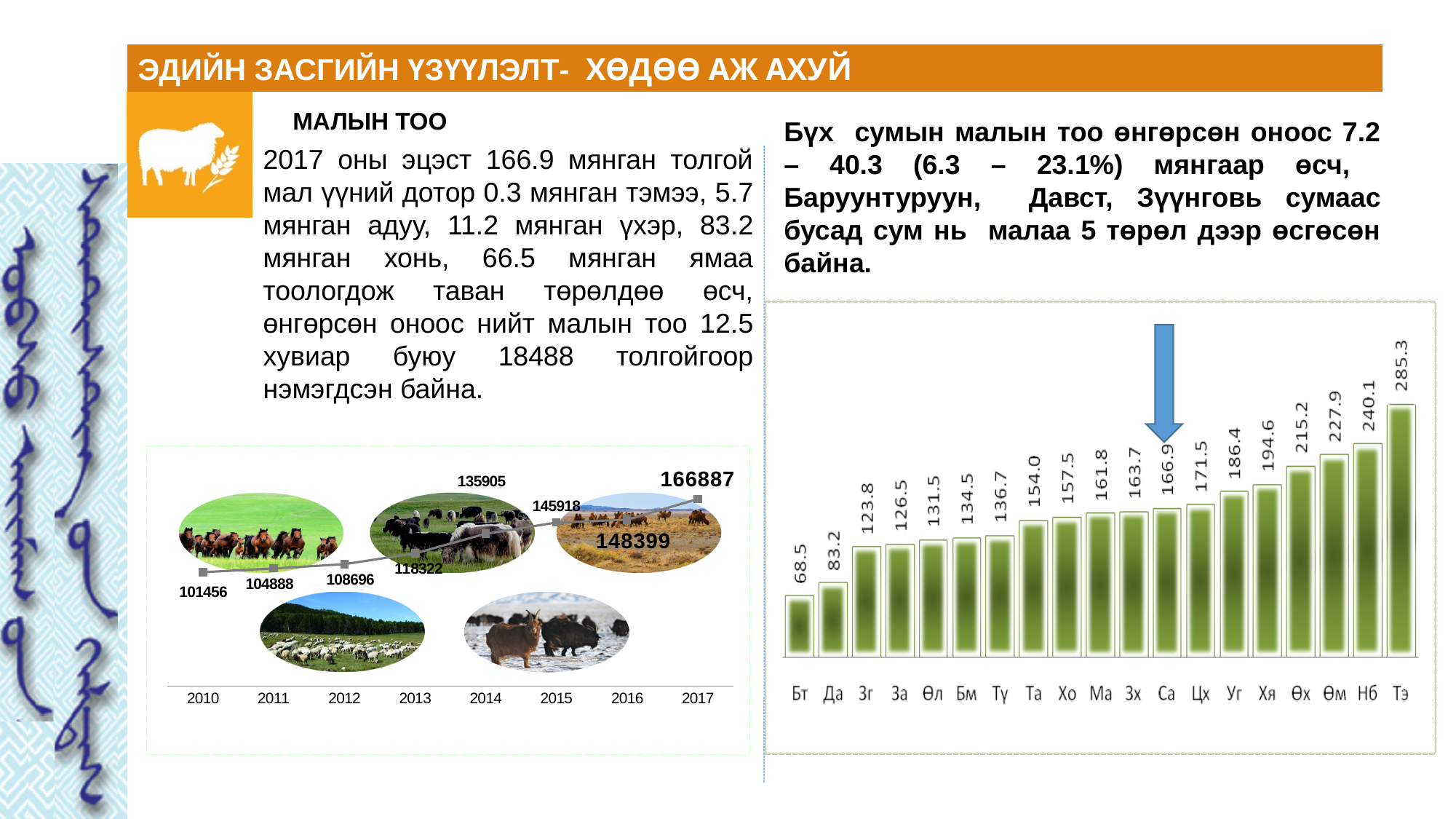
What type of chart is shown on the right side of the slide? bar chart In the line chart on the left, what is the value for 2010? 101456 In the line chart on the left, do the values rise or fall from 2010 to 2017? rise In the line chart on the left, how many years are shown on the x axis? 8 In the bar chart on the right, what is the value for Тэ? 285.3 In the bar chart on the right, what is the difference between the values for Нб and Бт? 171.6 In the bar chart on the right, which category has the highest value? Тэ In the line chart on the left, what is the value for 2017? 166887 In the bar chart on the right, which category has the lowest value? Бт In the bar chart on the right, what is the value for Са, the bar marked with the arrow? 166.9 In the bar chart on the right, which is larger, the value for Уг or the value for Хо? Уг In the bar chart on the right, how many categories are shown? 19